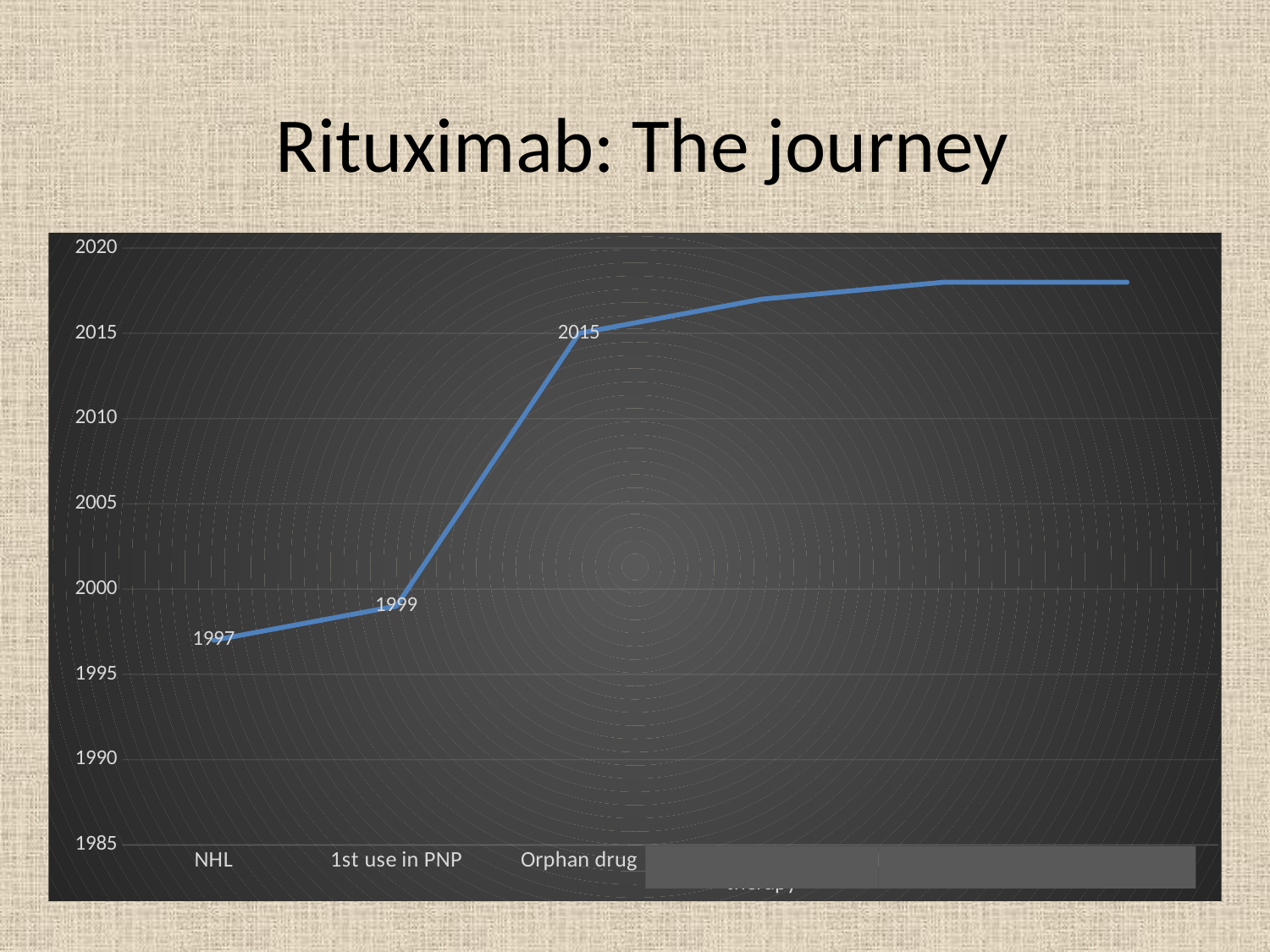
What is the title of the slide? Rituximab: The journey Do the values rise or fall from left to right along the x axis? rise What value is shown for NHL? 1997 What value is shown for Orphan drug? 2015 Is the value for Orphan drug greater or less than 2010? greater What value is shown for 1st use in PNP? 1999 Is the value for NHL greater or less than 2000? less Which has the larger value, Orphan drug or NHL? Orphan drug Which category has the lowest value? NHL What is the difference between the values for Orphan drug and 1st use in PNP? 16 What kind of chart is shown on the slide? line chart What is the difference between the values for 1st use in PNP and NHL? 2